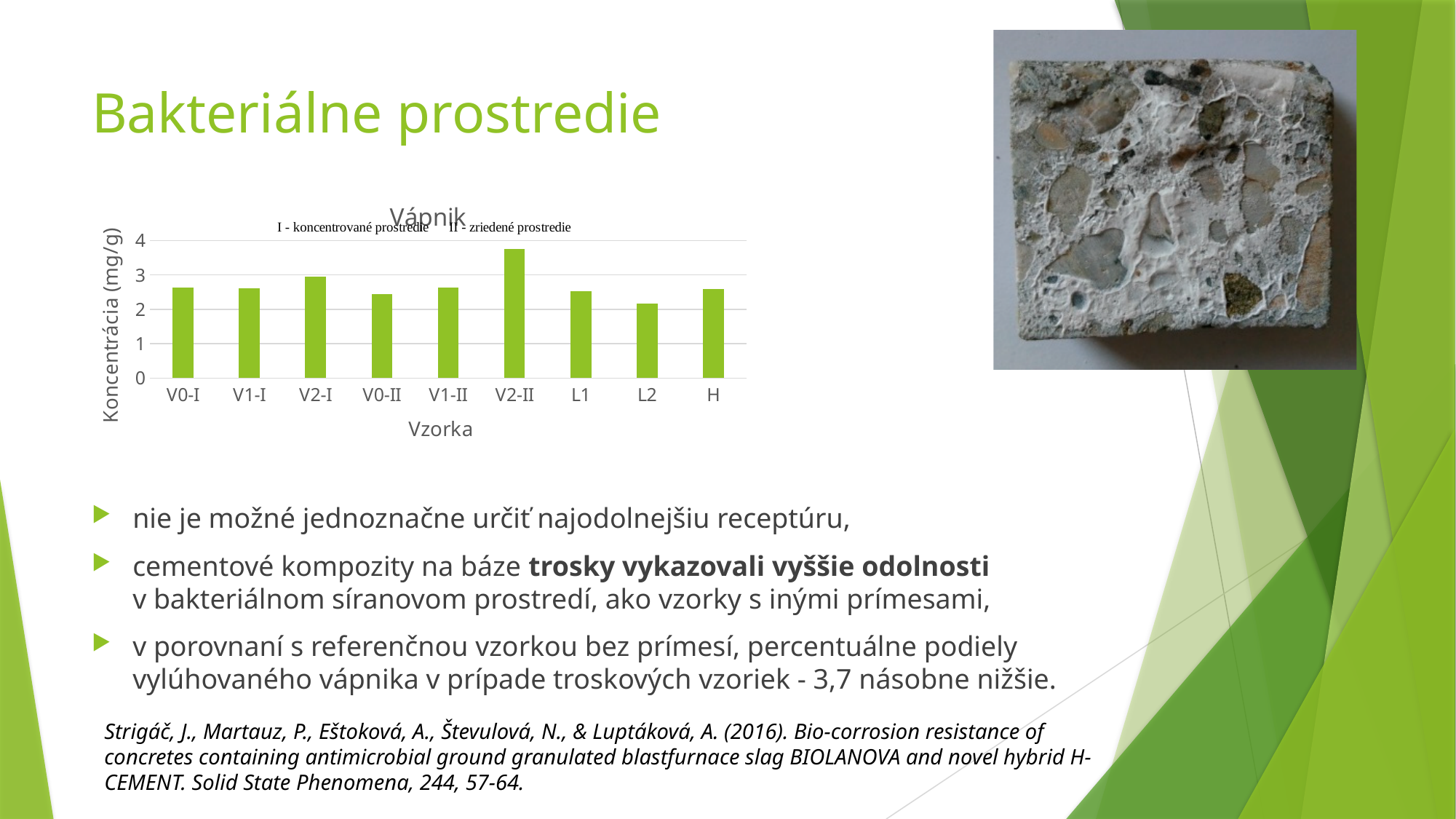
What kind of chart is shown on the slide? bar chart Is the value for V0-II greater or less than 3? less Which sample has the lowest calcium concentration in the chart? L2 Is the value for V1-I greater or less than 1? greater Which has the larger value, V2-II or V0-I? V2-II How many samples (categories) are plotted on the x axis of the chart? 9 Which sample has the highest calcium concentration in the chart? V2-II Is the value for L2 greater or less than 2? greater What is the title of the chart? Vápnik What is the label of the vertical axis of the chart? Koncentrácia (mg/g) Which has the larger value, V2-I or L2? V2-I